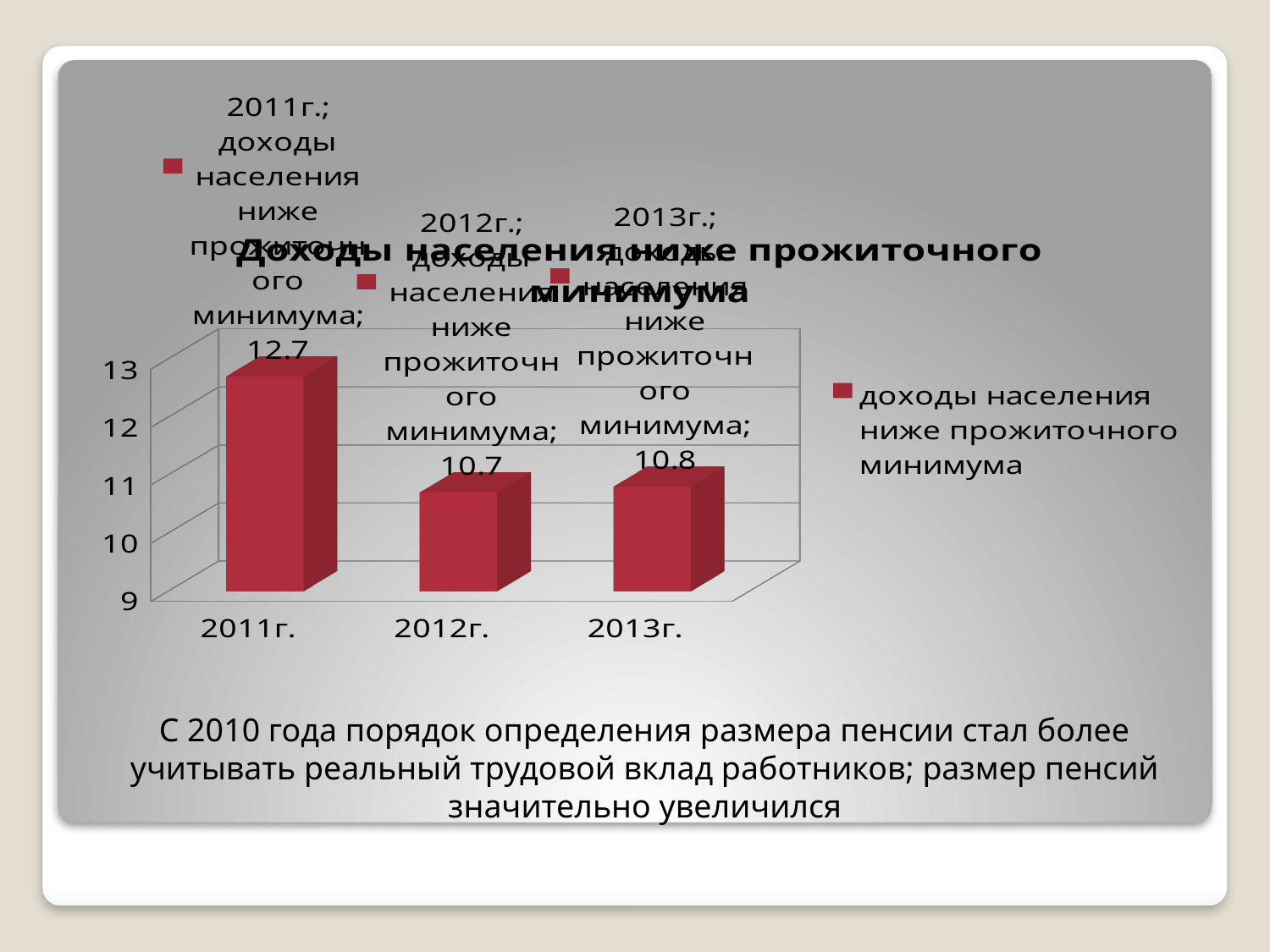
What is the value for 2012г.? 10.7 What is the difference between the values for 2013г. and 2012г.? 0.1 Which year has the lowest value? 2012г. Which is larger, the value for 2011г. or the value for 2013г.? 2011г. What kind of chart is shown on the slide? bar chart How many years are shown on the x axis? 3 Is the value for 2011г. greater or less than 12? greater Which year has the highest value? 2011г. What is the value for 2011г.? 12.7 How many series does the legend list? 1 What is the difference between the values for 2011г. and 2012г.? 2 What is the value for 2013г.? 10.8